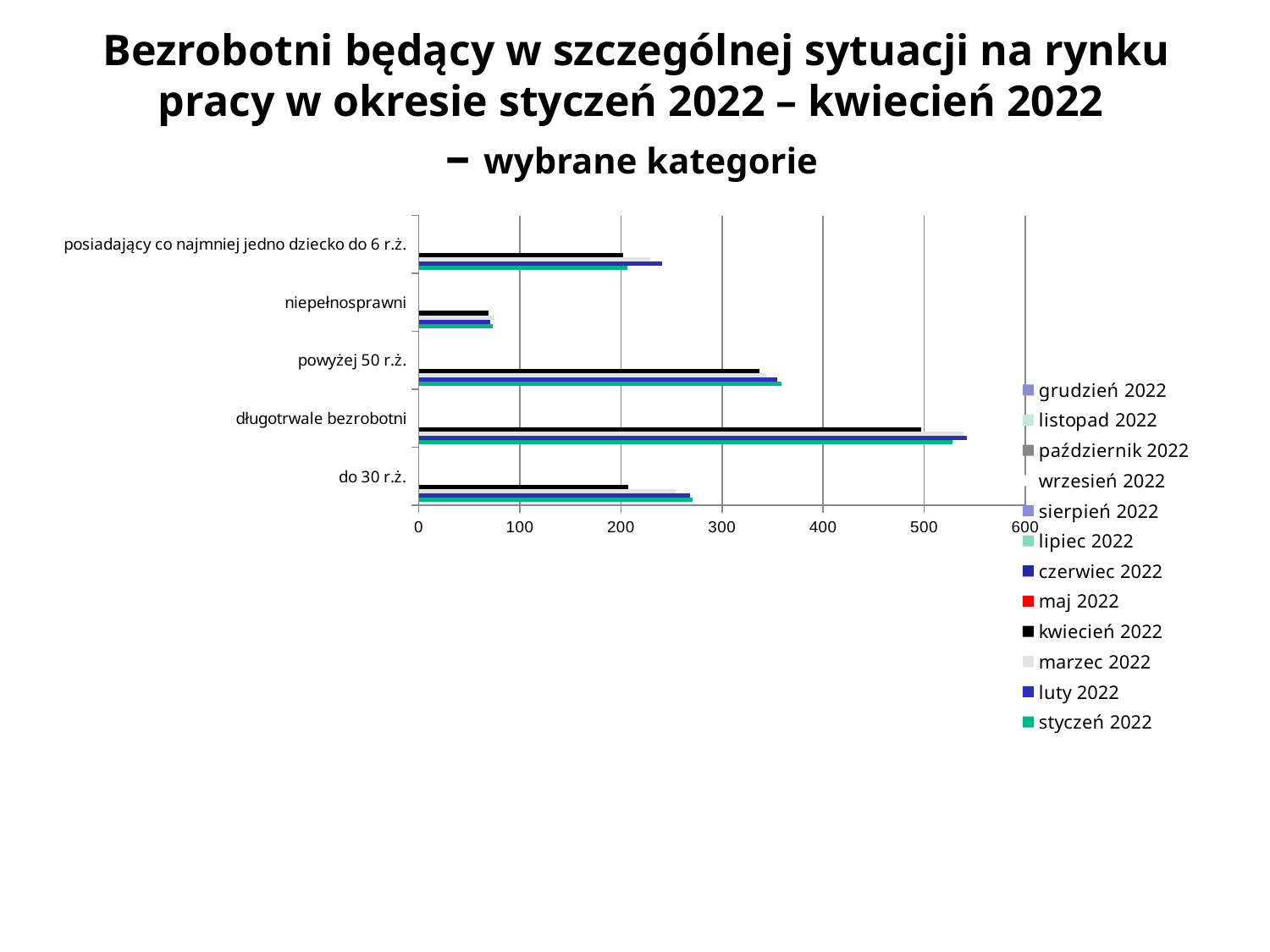
How many categories are shown on the vertical axis of the chart? 5 How many series does the chart's legend list? 12 What colour represents kwiecień 2022 in the legend? black Is the value for niepełnosprawni in kwiecień 2022 greater or less than 100? less What is the highest value shown on the horizontal axis of the chart? 600 Is the value for długotrwale bezrobotni in styczeń 2022 greater or less than 500? greater What kind of chart is shown on the slide? bar chart For styczeń 2022, which is larger: the value for powyżej 50 r.ż. or the value for do 30 r.ż.? powyżej 50 r.ż. Which category has the shortest bars in the chart? niepełnosprawni Is the value for posiadający co najmniej jedno dziecko do 6 r.ż. in luty 2022 greater or less than 200? greater Which category has the longest bars in the chart? długotrwale bezrobotni